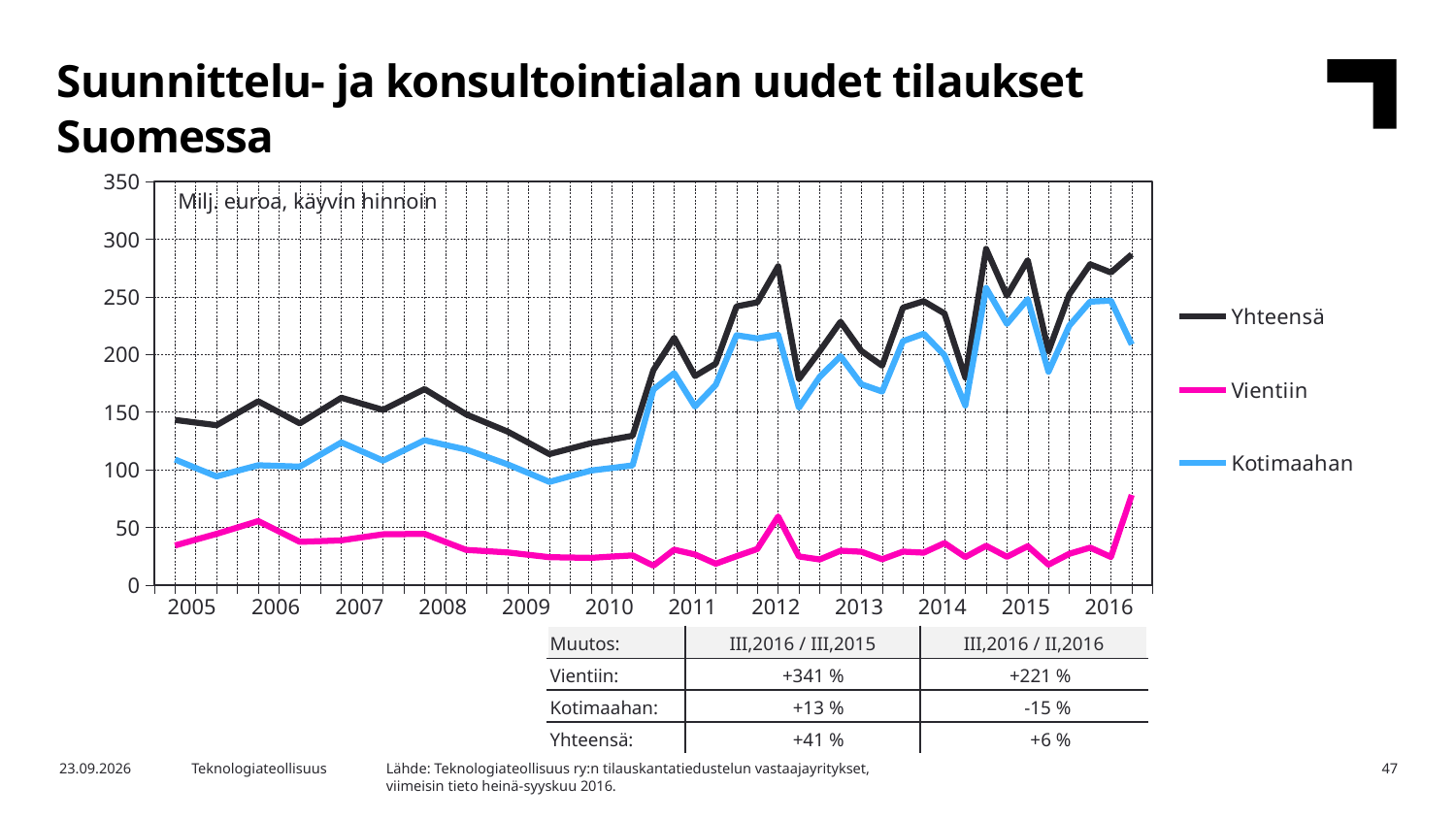
Overall, does the Yhteensä line rise or fall from 2005 to 2016? rise Is the first value for Yhteensä in 2005 greater or less than 100? greater What type of chart is shown on the slide? line chart How many series does the chart legend list? 3 What unit label is printed inside the chart area? Milj. euroa, käyvin hinnoin Which series has the lowest values across the whole chart? Vientiin Which series has the highest values across the whole chart? Yhteensä How many years are labelled on the x axis of the chart? 12 Is the highest value of Kotimaahan greater or less than 200? greater Is the first value for Vientiin in 2005 greater or less than 50? less What are the three series named in the chart legend? Yhteensä, Vientiin, Kotimaahan